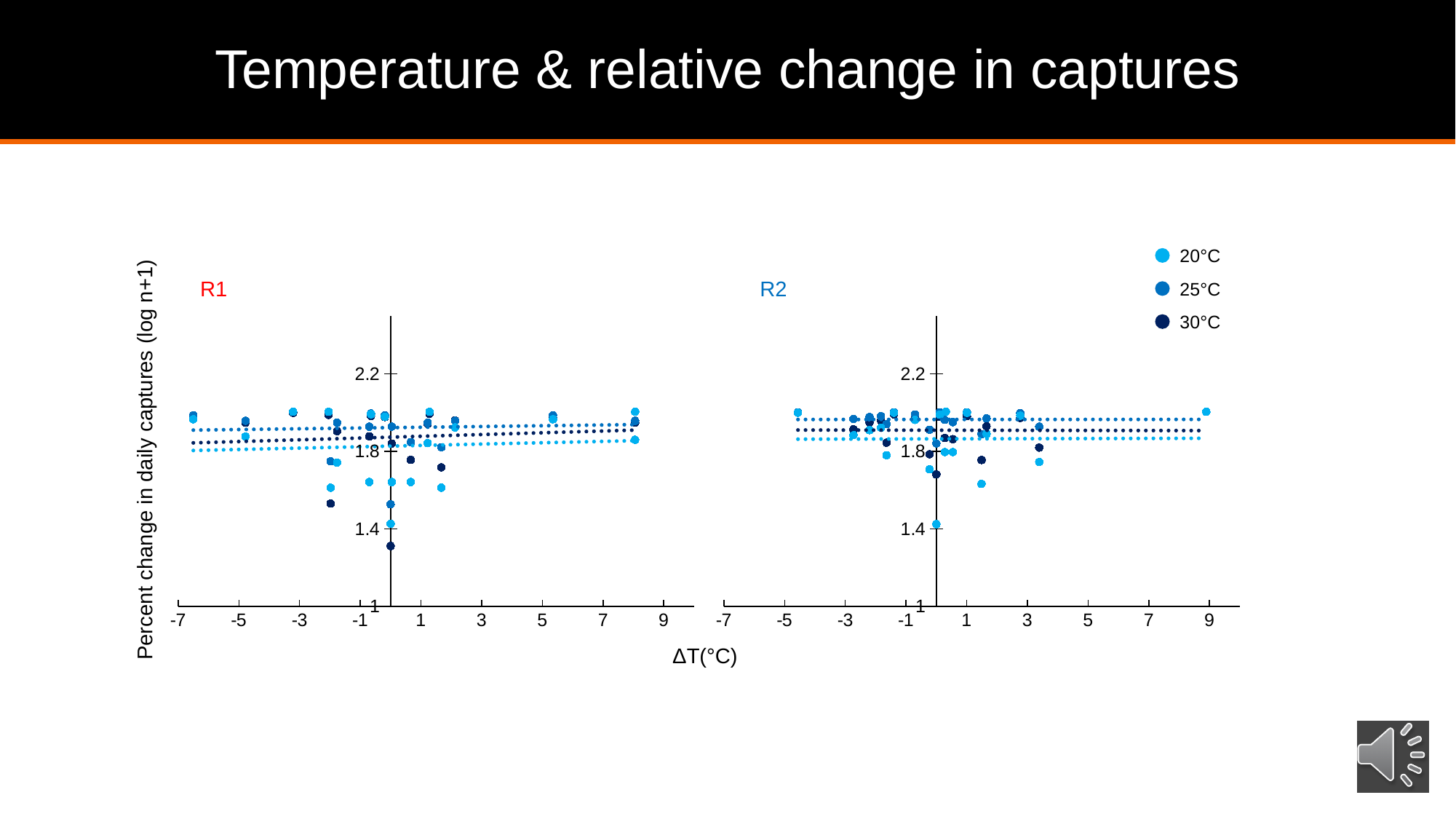
In the R1 chart, is the lowest plotted point greater or less than 1.4? less What are the three series named in the legend? 20°C, 25°C, 30°C How many series does the legend list? 3 How many charts are shown on the slide? 2 In the R2 chart, do the dotted trend lines rise steeply, fall steeply, or stay roughly flat across the x axis? Roughly flat In the R2 chart, is the highest plotted point greater or less than 2.2? less In the R1 chart, is the highest plotted point greater or less than 2.2? less What kind of chart is used for R1 and R2? Scatter chart Which chart, R1 or R2, contains the lowest plotted point? R1 In the R1 chart, do the dotted trend lines rise steeply, fall steeply, or stay roughly flat across the x axis? Roughly flat What is the label of the x axis shared by the two charts? ΔT(°C)